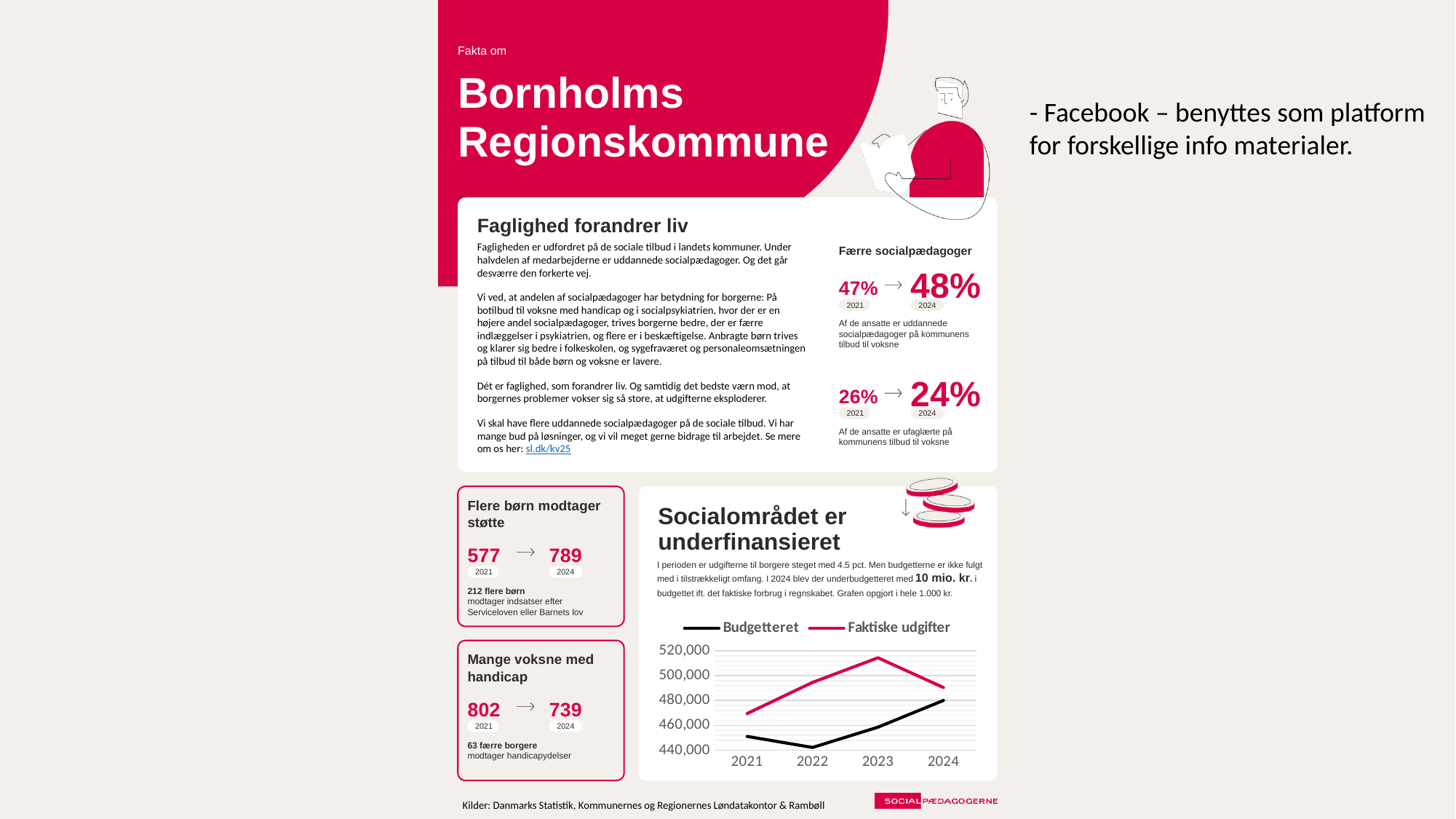
In the 'Socialområdet er underfinansieret' chart, in which year is Budgetteret highest? 2024 How many series does the legend of the 'Socialområdet er underfinansieret' chart list? 2 In the 'Socialområdet er underfinansieret' chart, does Budgetteret rise or fall from 2022 to 2024? rise In the 'Socialområdet er underfinansieret' chart, which is larger in 2024: Budgetteret or Faktiske udgifter? Faktiske udgifter In the 'Socialområdet er underfinansieret' chart, what colour is the Faktiske udgifter line? red In the 'Socialområdet er underfinansieret' chart, is the value for Budgetteret in 2022 greater or less than 460,000? less In the 'Socialområdet er underfinansieret' chart, in which year is Faktiske udgifter highest? 2023 What kind of chart is shown under the heading 'Socialområdet er underfinansieret'? line chart How many years are plotted on the x axis of the 'Socialområdet er underfinansieret' chart? 4 In the 'Socialområdet er underfinansieret' chart, in which year is Budgetteret lowest? 2022 In the 'Socialområdet er underfinansieret' chart, is the value for Faktiske udgifter in 2023 greater or less than 500,000? greater In the 'Socialområdet er underfinansieret' chart, is the value for Faktiske udgifter in 2021 greater or less than 480,000? less